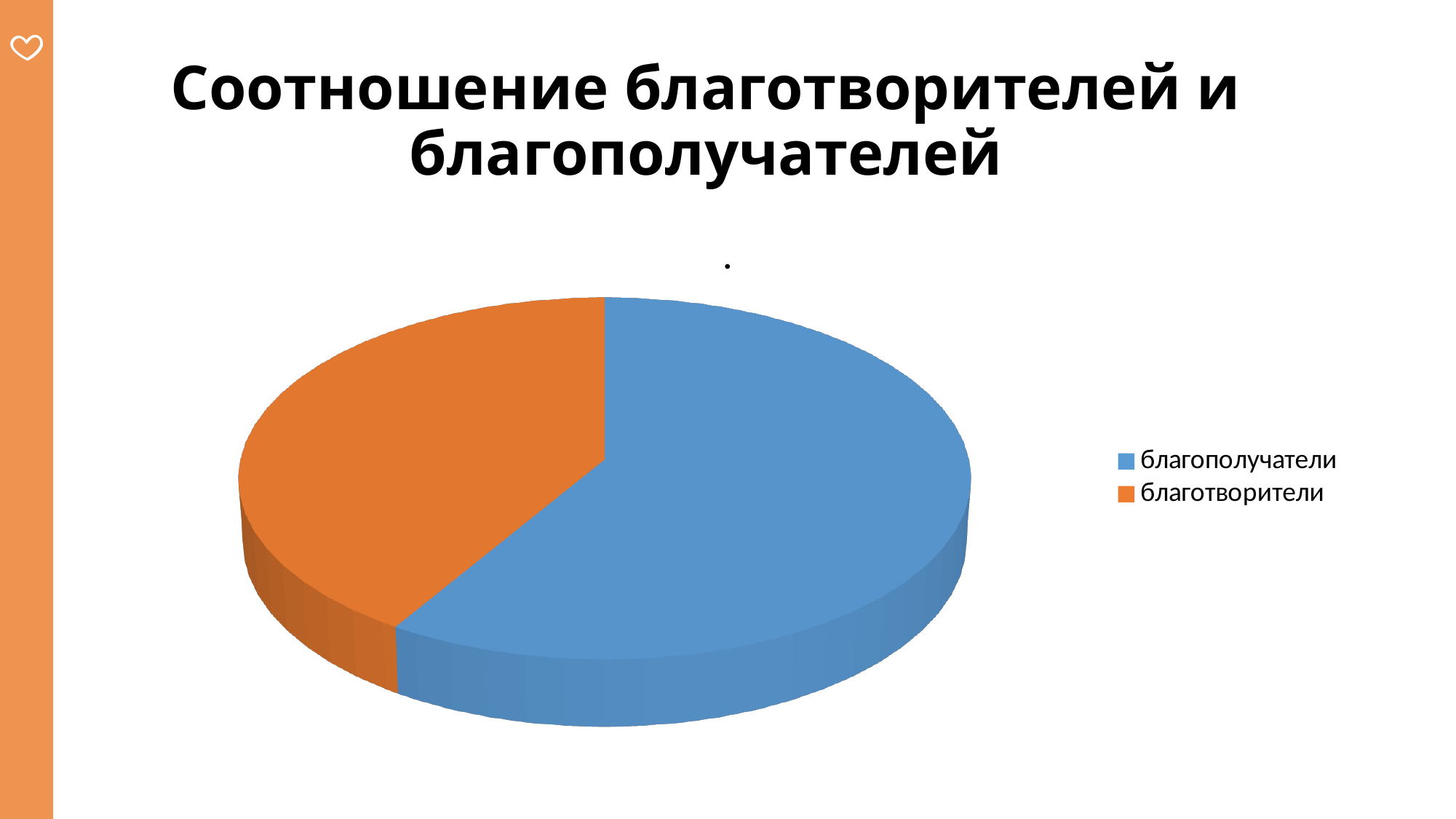
What is the title of the chart on the slide? Соотношение благотворителей и благополучателей What colour is the slice for благотворители? orange How many entries does the legend list? 2 What kind of chart is shown on the slide? pie chart Which category has the largest slice of the pie? благополучатели Which category has the smallest slice of the pie? благотворители Is the slice for благотворители larger or smaller than the slice for благополучатели? smaller Which slice is larger, благополучатели or благотворители? благополучатели How many slices does the pie chart have? 2